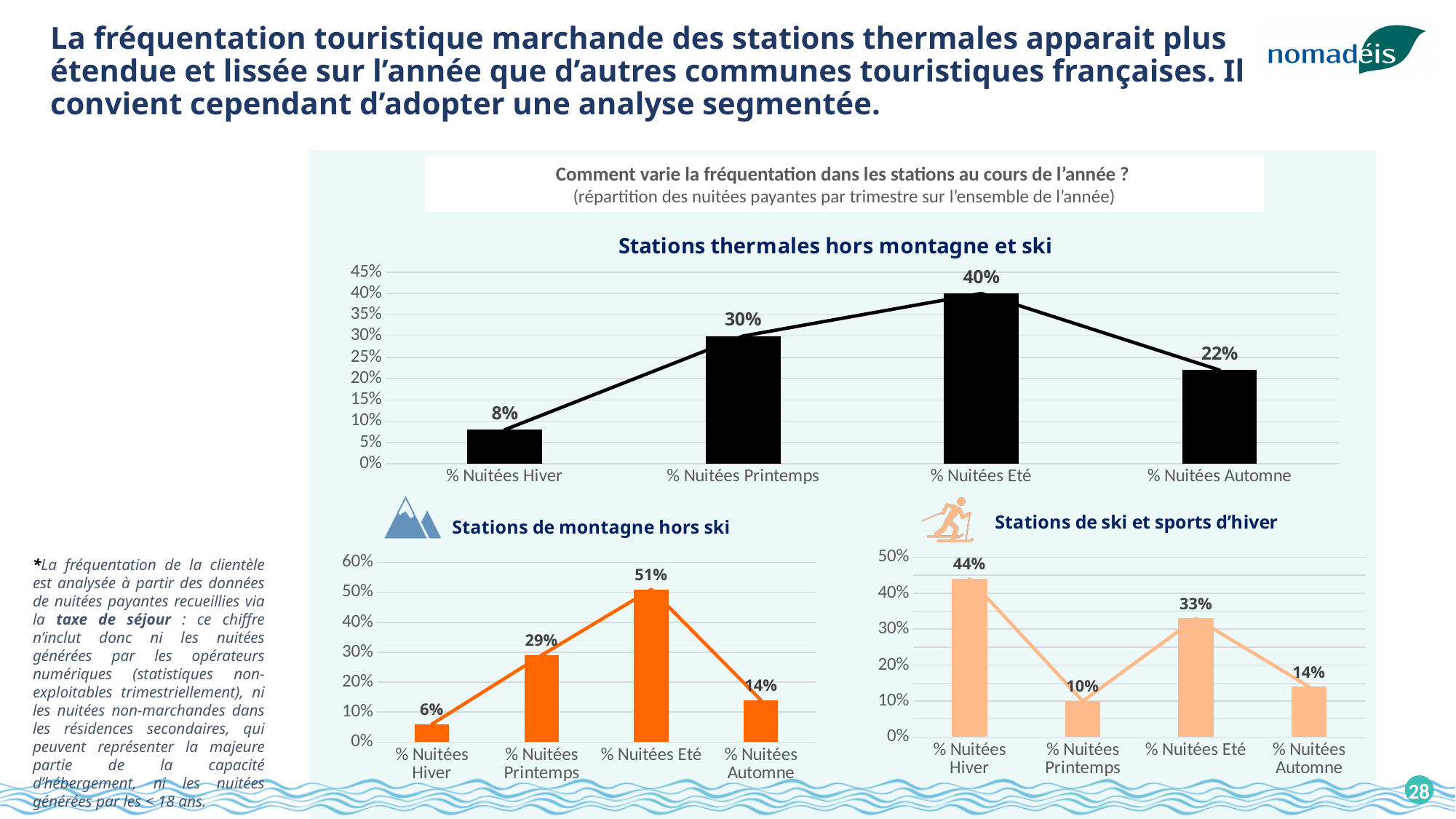
How many categories are shown in the 'Stations thermales hors montagne et ski' chart? 4 In the 'Stations thermales hors montagne et ski' chart, what is the value for % Nuitées Eté? 40% In the 'Stations thermales hors montagne et ski' chart, what is the difference between % Nuitées Eté and % Nuitées Automne? 18% In the 'Stations thermales hors montagne et ski' chart, which category has the lowest value? % Nuitées Hiver In the 'Stations de ski et sports d'hiver' chart, what is the difference between % Nuitées Hiver and % Nuitées Eté? 11% In the 'Stations de ski et sports d'hiver' chart, which is larger: % Nuitées Eté or % Nuitées Automne? % Nuitées Eté In the 'Stations de montagne hors ski' chart, is the value for % Nuitées Eté greater or less than 50%? greater In the 'Stations de montagne hors ski' chart, what is the value for % Nuitées Printemps? 29% What kind of chart is the 'Stations de montagne hors ski' chart? Bar chart with a line overlay In the 'Stations de ski et sports d'hiver' chart, which category has the lowest value? % Nuitées Printemps In the 'Stations de montagne hors ski' chart, which category has the highest value? % Nuitées Eté In the 'Stations de ski et sports d'hiver' chart, what is the value for % Nuitées Hiver? 44%